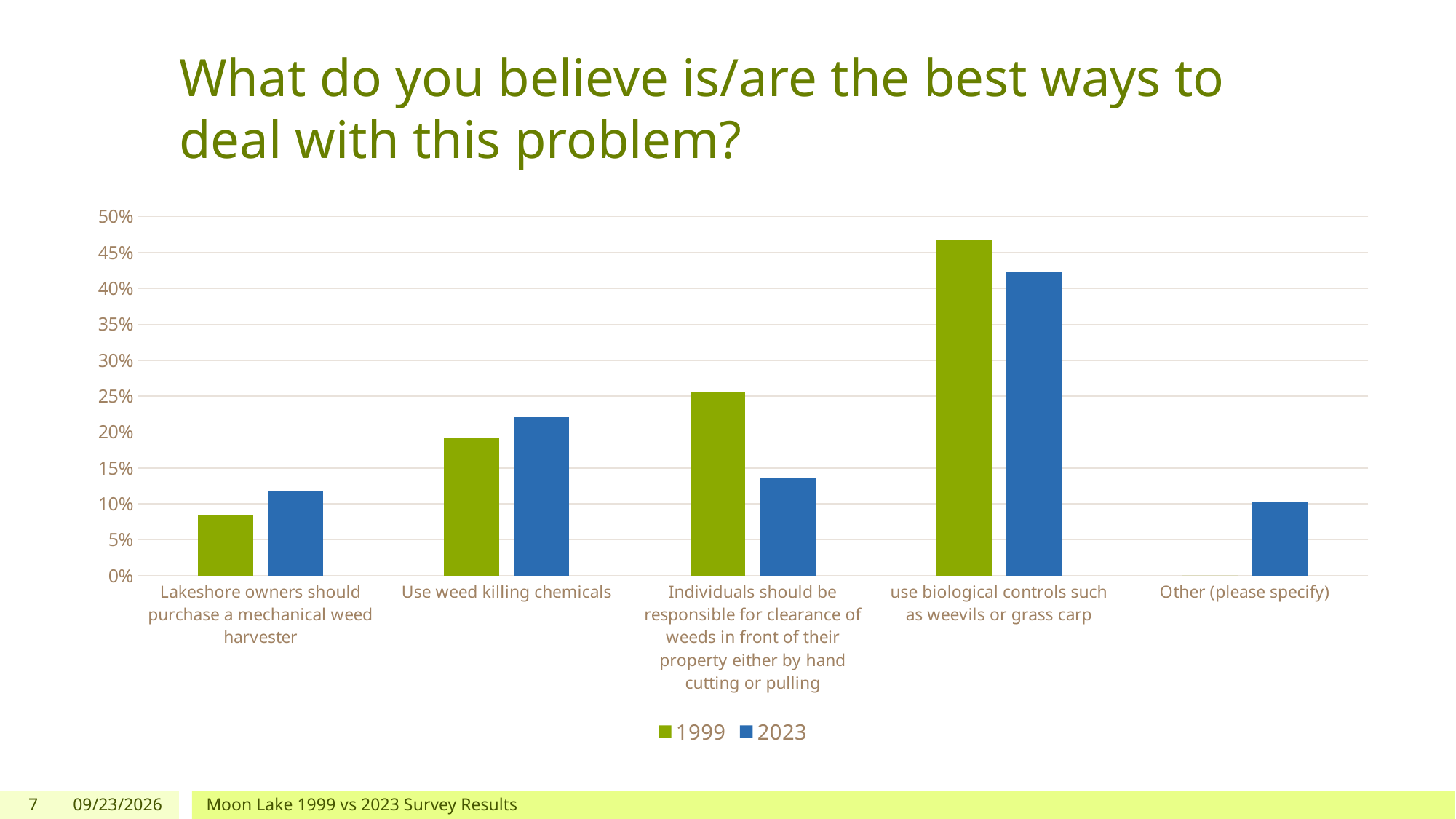
For 'Individuals should be responsible for clearance of weeds in front of their property either by hand cutting or pulling', which series has the larger value, 1999 or 2023? 1999 Which category has the highest value for 1999? use biological controls such as weevils or grass carp For 'Use weed killing chemicals', which series has the larger value, 1999 or 2023? 2023 Which category has the lowest value for 2023? Other (please specify) Is the 2023 value for 'use biological controls such as weevils or grass carp' greater or less than 40%? greater Is the 1999 value for 'Lakeshore owners should purchase a mechanical weed harvester' greater or less than 10%? less What kind of chart is shown on the slide? bar chart Which category has the highest value for 2023? use biological controls such as weevils or grass carp Is the 1999 value for 'use biological controls such as weevils or grass carp' greater or less than 45%? greater How many series does the legend list? 2 How many categories are shown on the x axis? 5